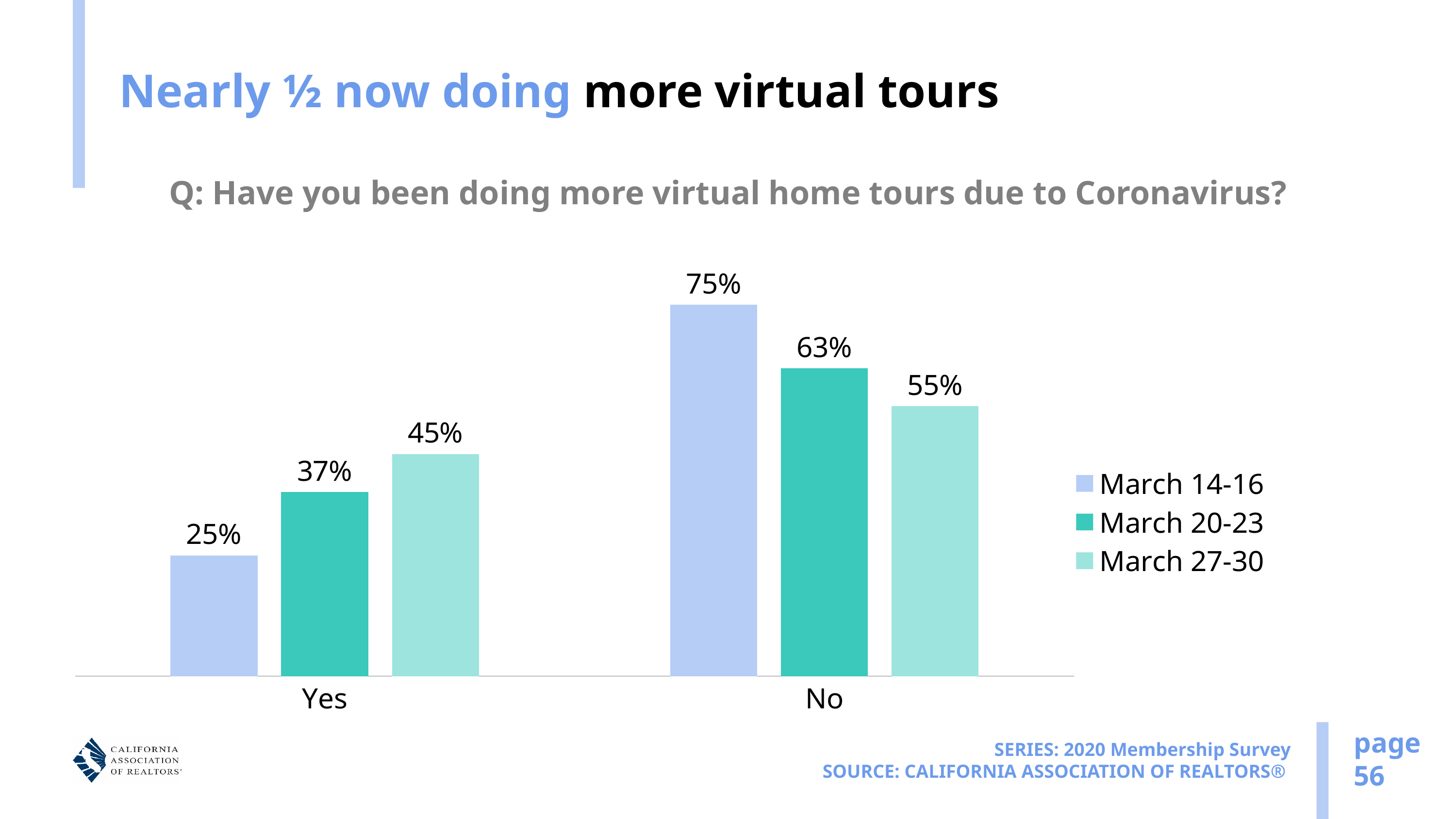
What percentage answered No in the March 27-30 survey? 55% What kind of chart is shown on the slide? Bar chart What percentage answered Yes in the March 20-23 survey? 37% What percentage answered Yes in the March 14-16 survey? 25% What is the difference between the No share in March 14-16 and the No share in March 20-23? 12% Does the Yes share rise or fall across the three survey periods from March 14-16 to March 27-30? Rise Which survey period has the highest share of No responses? March 14-16 How many series does the legend list? 3 Which survey period has the lowest share of Yes responses? March 14-16 What is the difference between the Yes share in March 27-30 and the Yes share in March 14-16? 20% Which is larger: the Yes share in March 27-30 or the No share in March 27-30? No share in March 27-30 How many categories are shown on the x axis? 2